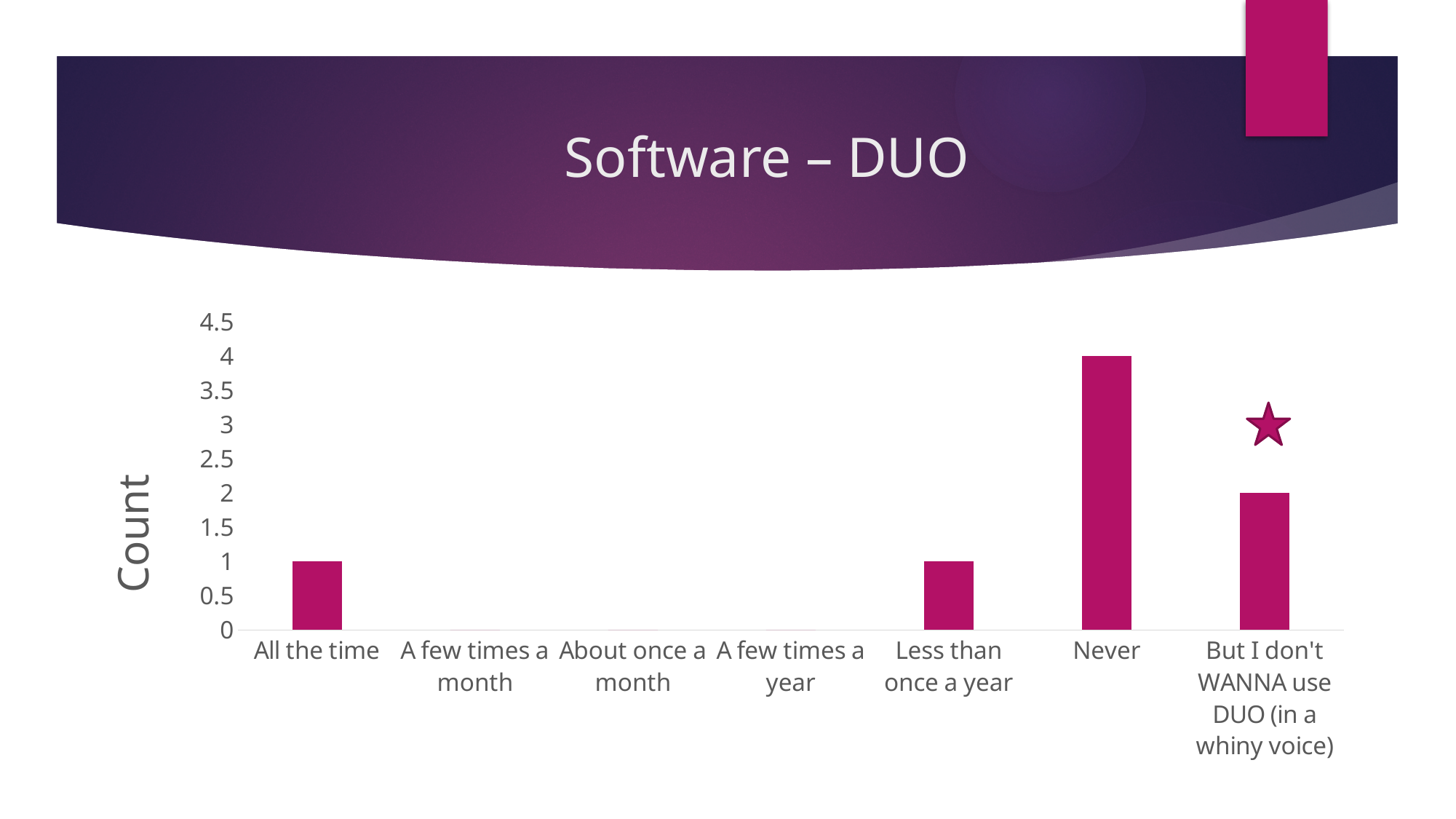
What is the count for Never? 4 What is the title of the slide containing the chart? Software – DUO What is the label of the y axis? Count Which is larger, the count for Never or the count for All the time? Never Is the count for Never greater or less than 3? greater What kind of chart is shown on the slide? bar chart What is the count for "But I don't WANNA use DUO (in a whiny voice)"? 2 How many categories are shown on the x axis of the chart? 7 What is the count for Less than once a year? 1 What is the difference between the count for Never and the count for "But I don't WANNA use DUO (in a whiny voice)"? 2 What is the count for All the time? 1 Which category has the highest count? Never